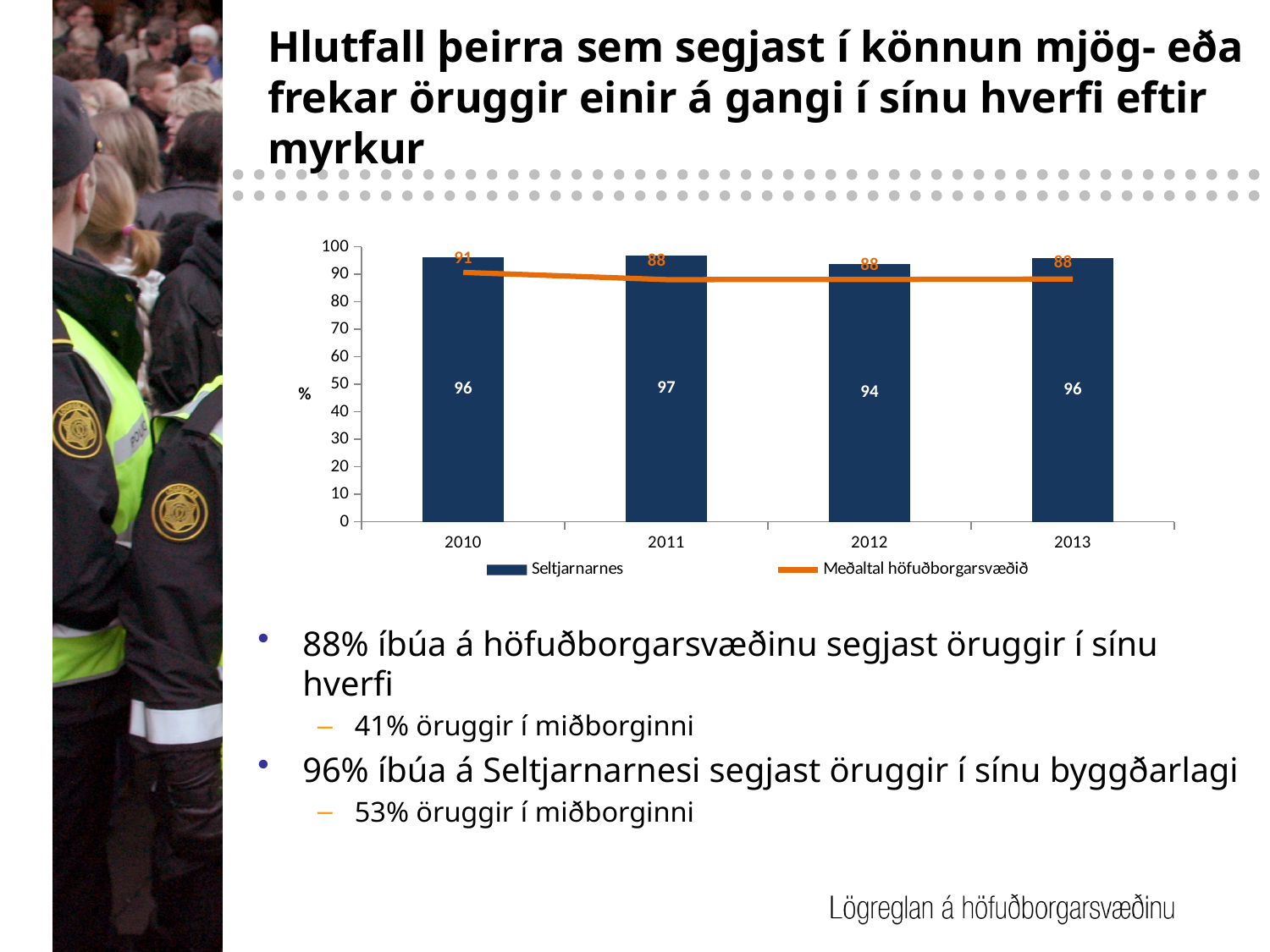
What label is shown on the y axis? % What is the value for Seltjarnarnes in 2011? 97 What is the value of Meðaltal höfuðborgarsvæðið in 2010? 91 What kind of chart is shown on the slide? Combined bar and line chart How many series does the legend list? 2 In which year is the Seltjarnarnes value lowest? 2012 What is the value of Meðaltal höfuðborgarsvæðið in 2013? 88 In which year is the Seltjarnarnes value highest? 2011 What is the difference between the Seltjarnarnes value and the Meðaltal höfuðborgarsvæðið value in 2013? 8 What is the value for Seltjarnarnes in 2012? 94 Which is larger in 2010: the Seltjarnarnes value or the Meðaltal höfuðborgarsvæðið value? Seltjarnarnes How many years are shown on the x axis? 4